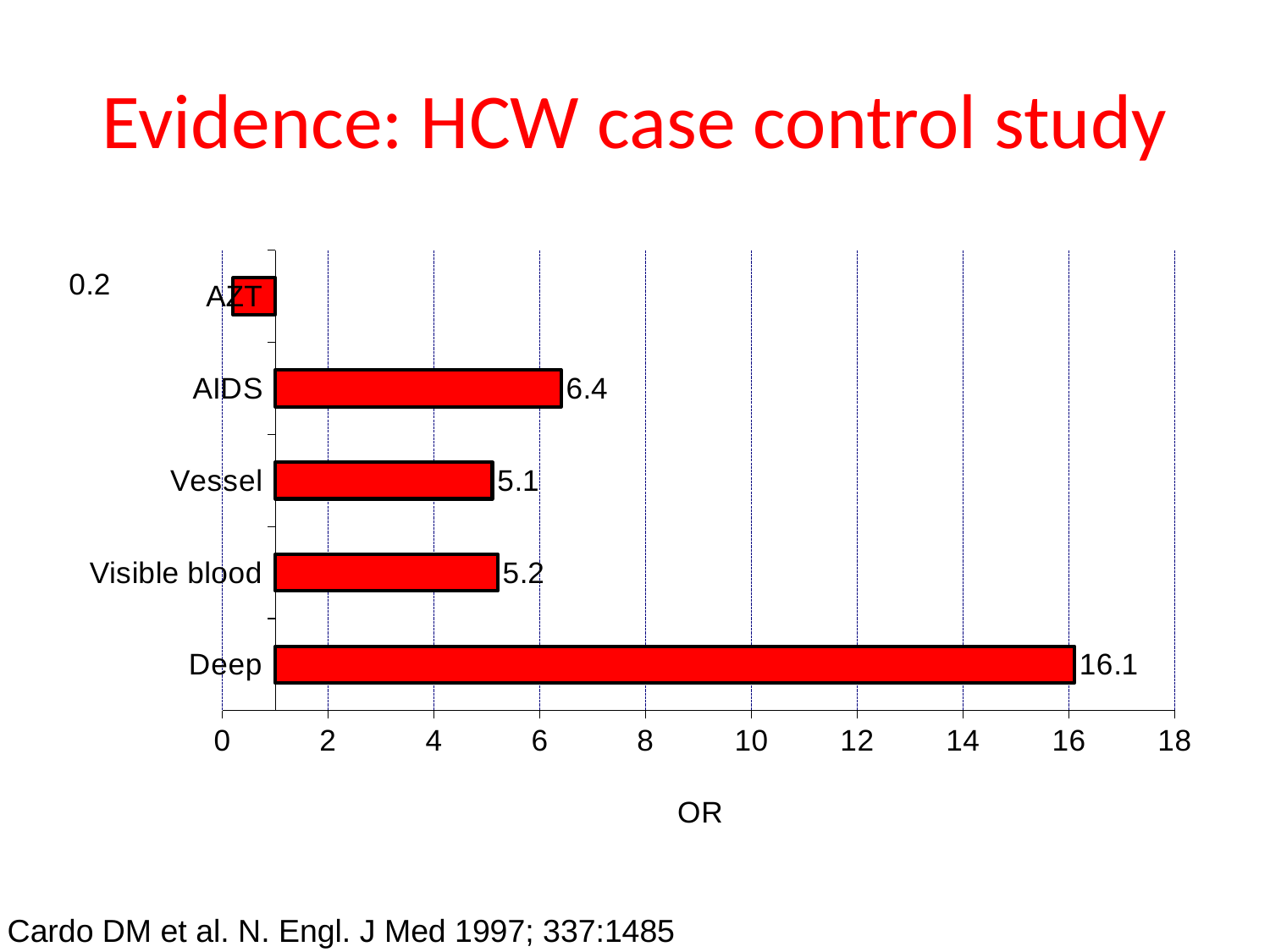
What is the OR value shown for AIDS? 6.4 What is the difference between the OR values for Deep and AIDS? 9.7 What is the odds ratio (OR) value shown for Deep? 16.1 Which category has the lowest OR value? AZT What is the OR value shown for Visible blood? 5.2 How many categories are shown in the chart? 5 What is the difference between the OR values for Visible blood and Vessel? 0.1 What is the OR value shown for AZT? 0.2 Which category has the highest OR value? Deep What kind of chart is shown on the slide? Bar chart Which has a larger OR value, AIDS or Vessel? AIDS What is the label of the horizontal axis? OR